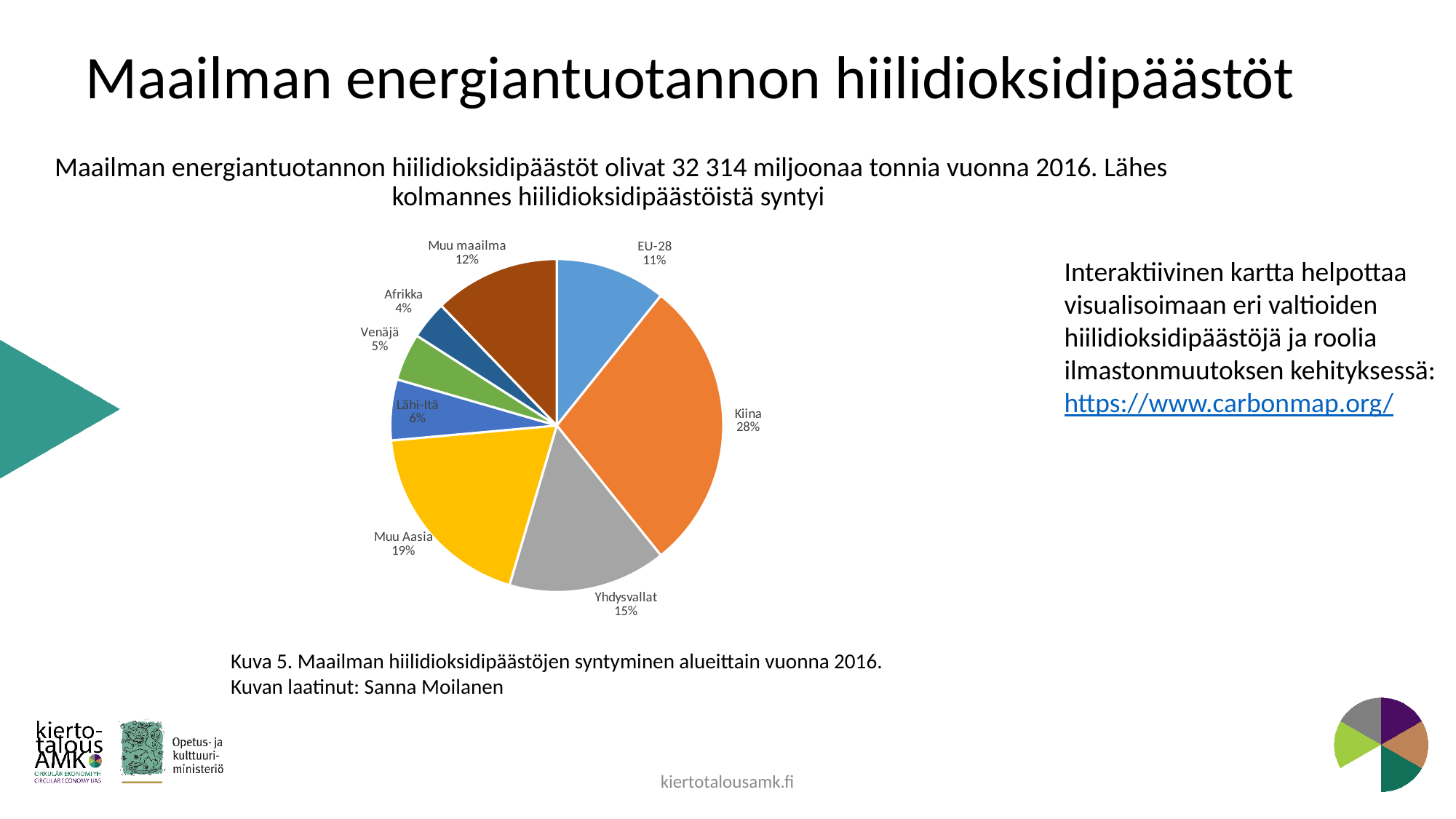
Which has a larger share, Muu maailma or Venäjä? Muu maailma How many slices does the pie chart have? 8 Which region has the smallest slice of the pie? Afrikka Which region has the largest slice of the pie? Kiina What share of the pie does Yhdysvallat have? 15% What share of the pie does Afrikka have? 4% What share of the pie does Kiina have? 28% What kind of chart is shown on the slide? Pie chart What share of the pie does Muu Aasia have? 19% What is the combined share of Lähi-Itä and Venäjä? 11% What share of the pie does EU-28 have? 11% What is the difference in percentage points between Kiina and Yhdysvallat? 13